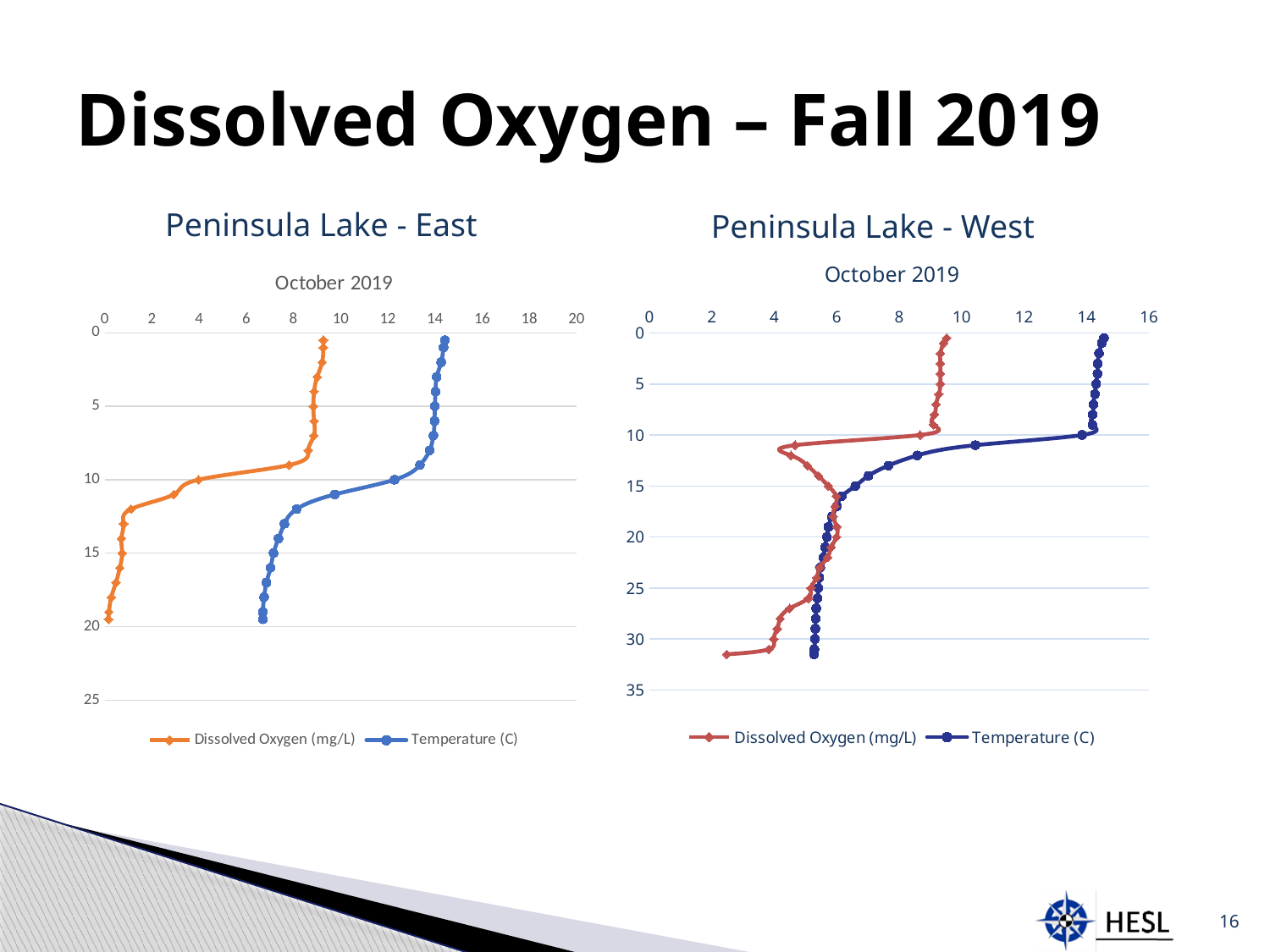
In the Peninsula Lake - East chart, is the Temperature (C) value at the surface (depth 0) greater or less than 12? greater In the Peninsula Lake - East chart, is the Temperature (C) value at the deepest point greater or less than 8? less In the Peninsula Lake - West chart, is the Temperature (C) value at a depth of 30 greater or less than 8? less In the Peninsula Lake - East chart, does Dissolved Oxygen (mg/L) generally increase or decrease as depth increases? decrease What are the two series named in the legend of the Peninsula Lake - East chart? Dissolved Oxygen (mg/L) and Temperature (C) What kind of chart is the Peninsula Lake - East chart? line chart How many series does the legend of the Peninsula Lake - West chart list? 2 In the Peninsula Lake - West chart, does Temperature (C) generally increase or decrease as depth increases? decrease What subtitle appears under the title of the Peninsula Lake - West chart? October 2019 In the Peninsula Lake - West chart, at the surface (depth 0), which series has the larger value: Dissolved Oxygen (mg/L) or Temperature (C)? Temperature (C)